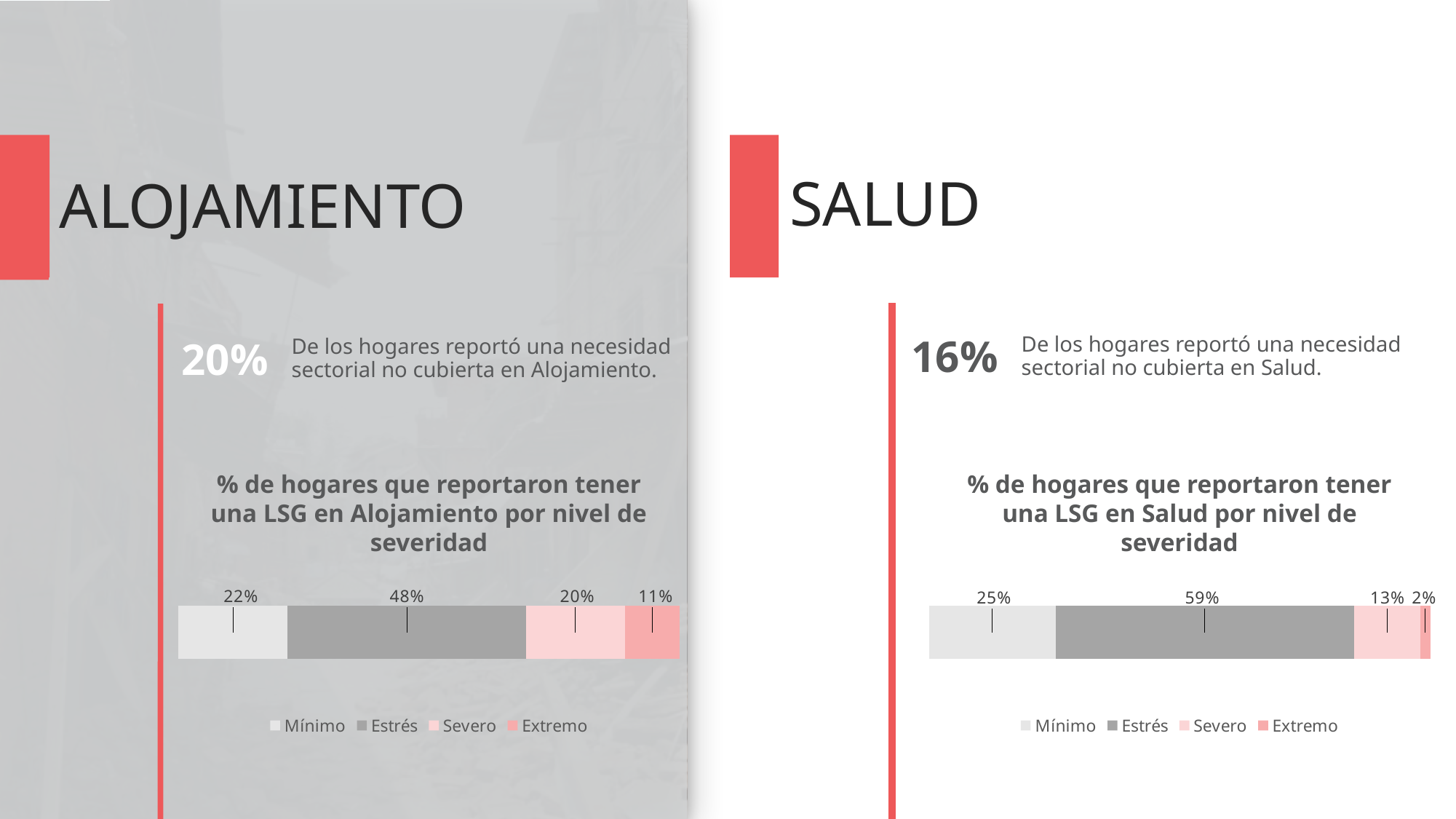
How many series does the legend of the Alojamiento chart list? 4 In the Salud chart, what is the value for Extremo? 2% In the Salud chart, which severity level has the lowest share? Extremo What is the title of the chart in the Alojamiento section? % de hogares que reportaron tener una LSG en Alojamiento por nivel de severidad Which is larger in the Salud chart: the Mínimo share or the Severo share? Mínimo In the Salud chart, what percentage of households reported an Estrés level of severity? 59% In the Alojamiento chart, which severity level has the highest share? Estrés In the Alojamiento chart, what percentage of households reported a Severo level of severity? 20% In the Alojamiento chart, what is the total of all four segments of the stacked bar? 101% In the Salud chart, what is the difference between the Severo and Extremo shares? 11% What kind of chart is used in the Salud section? Stacked bar chart In the Alojamiento chart, what is the difference between the Estrés and Mínimo shares? 26%